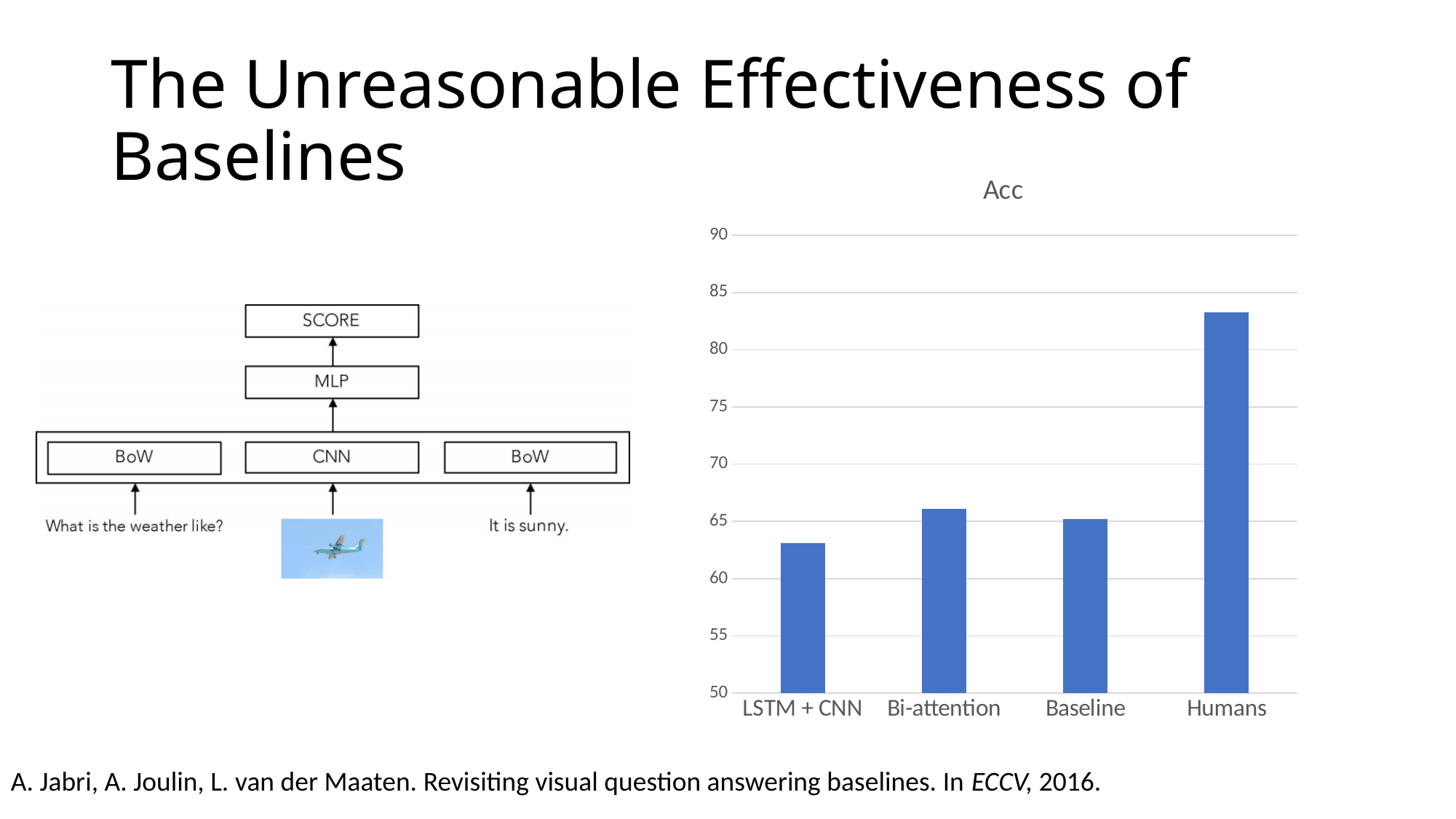
Is the value for LSTM + CNN greater or less than 65? less How many categories are shown on the x axis of the chart? 4 Which category has the highest value in the chart? Humans Is the value for Humans greater or less than 85? less Is the value for Humans greater or less than 80? greater Which category has the lowest value in the chart? LSTM + CNN Which is larger, the value for Humans or the value for Baseline? Humans What is the title of the chart? Acc Which is larger, the value for Bi-attention or the value for LSTM + CNN? Bi-attention What kind of chart is shown on the slide? bar chart